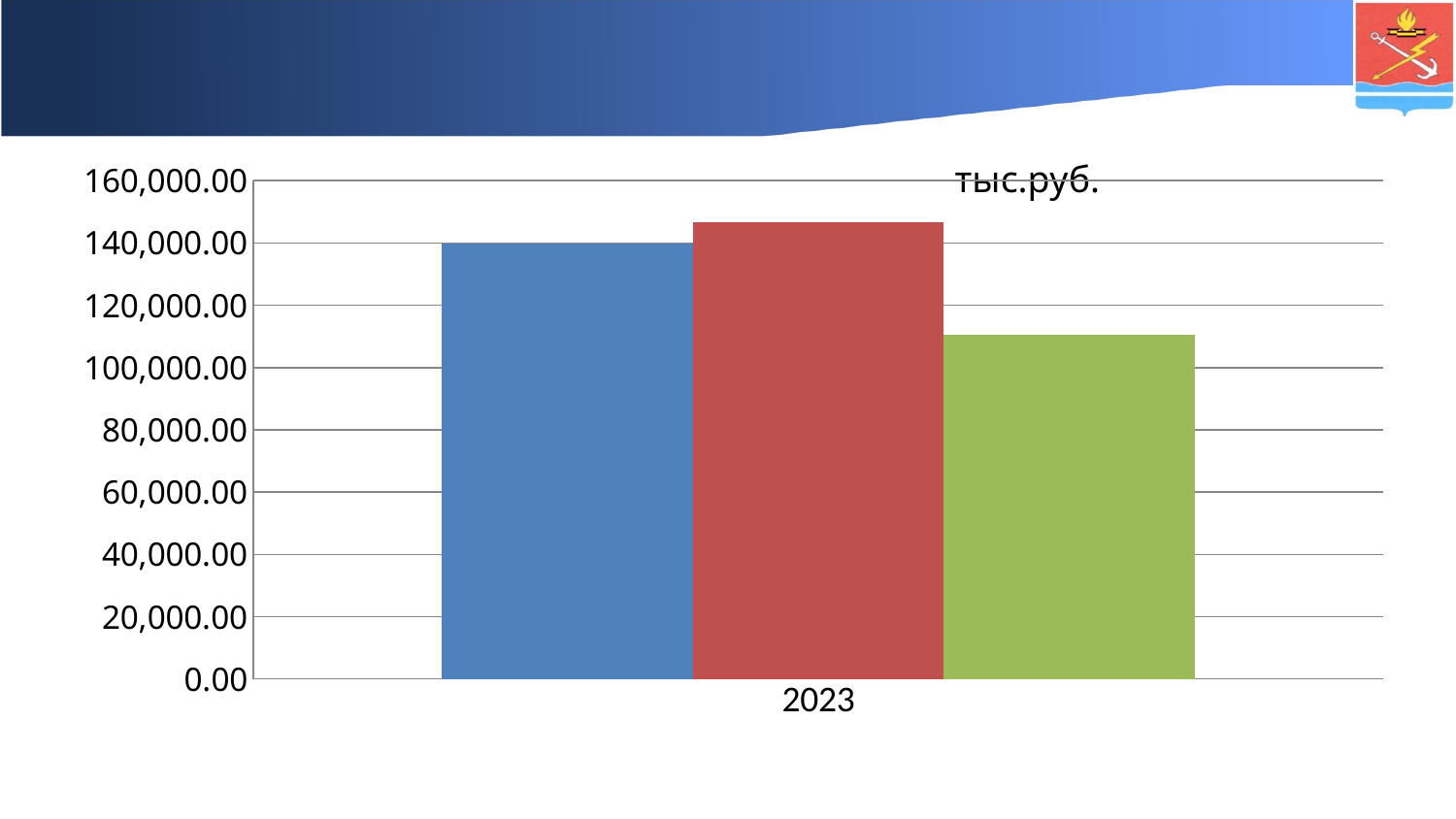
Which is larger: the value of the blue bar or the green bar? blue Is the value of the green bar greater or less than 100,000.00? greater Is the value of the green bar greater or less than 120,000.00? less Which bar is the tallest for 2023: the blue, red or green one? red Is the value of the blue bar greater or less than 120,000.00? greater What unit label is shown at the top of the chart? тыс.руб. How many categories are shown on the x axis of the chart? 1 What kind of chart is shown on the slide? bar chart Which bar is the shortest for 2023: the blue, red or green one? green How many bars are plotted for 2023? 3 What is the category label shown on the x axis? 2023